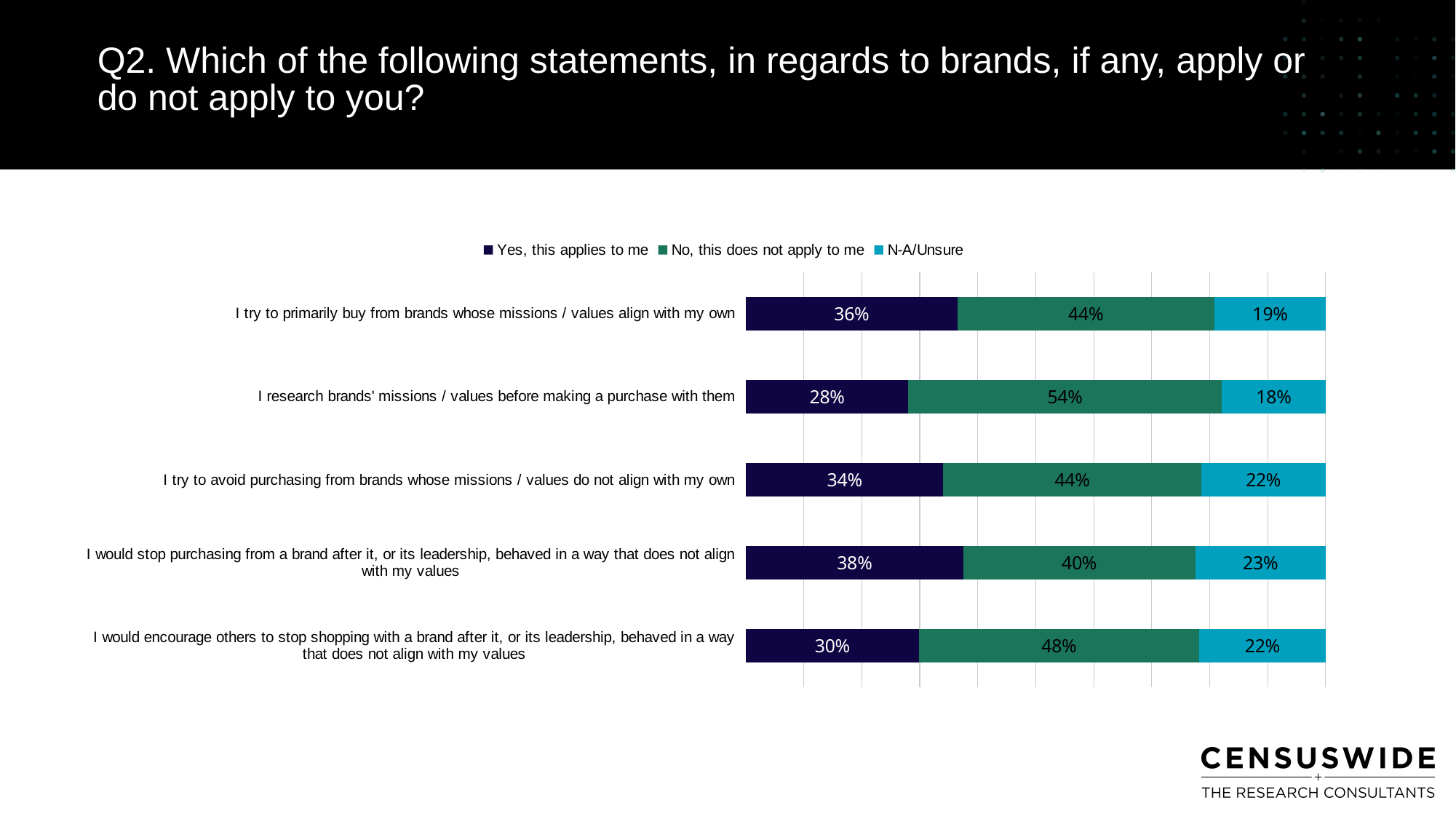
Which is larger: the "Yes, this applies to me" value for "I try to avoid purchasing from brands whose missions / values do not align with my own" or for "I research brands' missions / values before making a purchase with them"? I try to avoid purchasing from brands whose missions / values do not align with my own What percentage said "No, this does not apply to me" for "I research brands' missions / values before making a purchase with them"? 54% Which statement has the highest "Yes, this applies to me" percentage? I would stop purchasing from a brand after it, or its leadership, behaved in a way that does not align with my values How many statements (categories) are shown in the chart? 5 What is the N-A/Unsure value for "I would stop purchasing from a brand after it, or its leadership, behaved in a way that does not align with my values"? 23% What kind of chart is shown on the slide? Stacked bar chart What percentage said "Yes, this applies to me" for "I try to primarily buy from brands whose missions / values align with my own"? 36% Which statement has the highest "No, this does not apply to me" percentage? I research brands' missions / values before making a purchase with them Which statement has the lowest "Yes, this applies to me" percentage? I research brands' missions / values before making a purchase with them What is the third series listed in the legend? N-A/Unsure How many series does the legend list? 3 What is the difference between the "No, this does not apply to me" and "Yes, this applies to me" percentages for "I would encourage others to stop shopping with a brand after it, or its leadership, behaved in a way that does not align with my values"? 18%